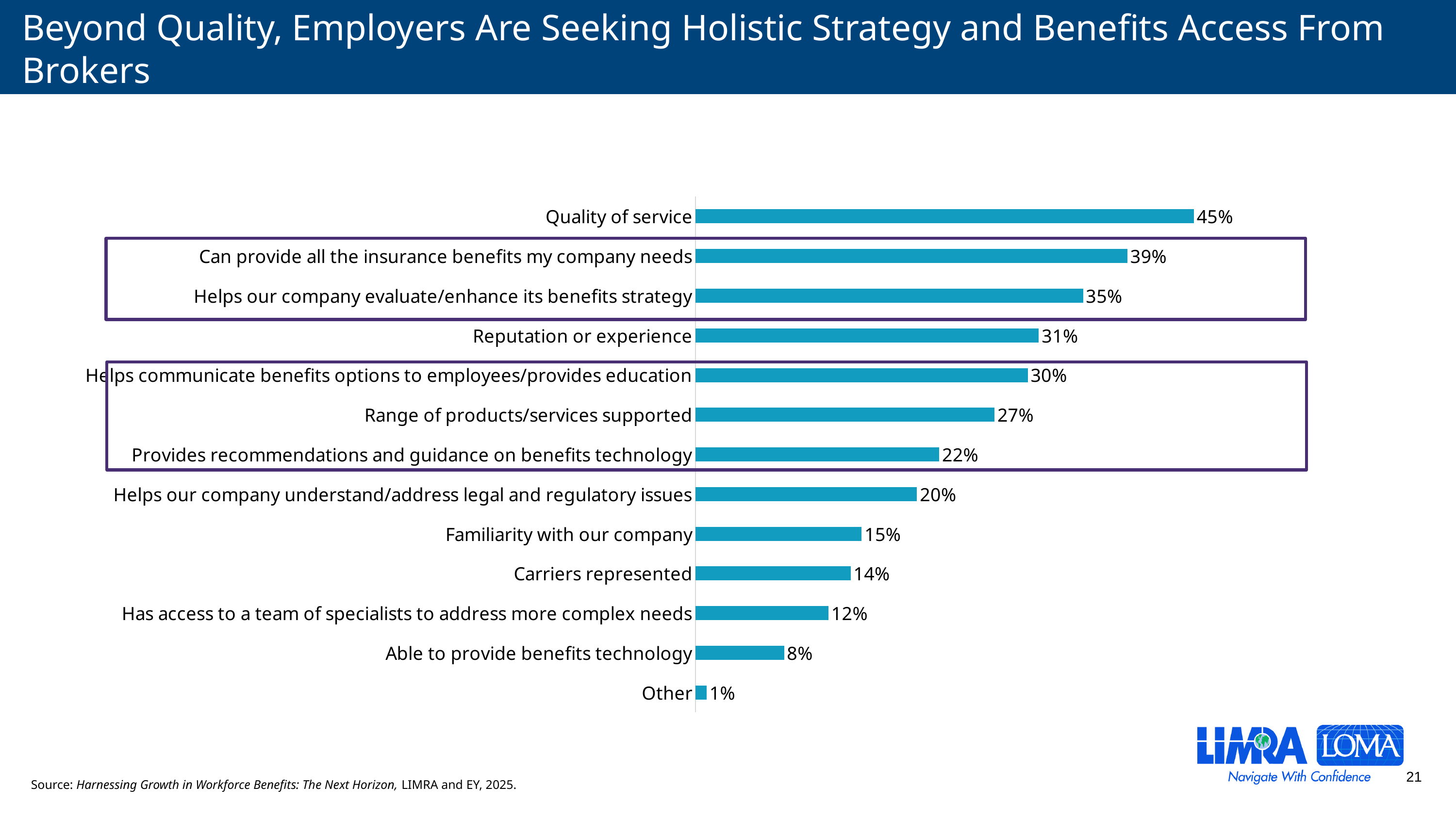
What is the value for Carriers represented? 14% How many categories are enclosed in the two outlined boxes in total? 5 What kind of chart is shown on the slide? Bar chart What is the value for Able to provide benefits technology? 8% What is the difference between Range of products/services supported and Provides recommendations and guidance on benefits technology? 5% Which is larger: Reputation or experience or Familiarity with our company? Reputation or experience What is the value for Helps our company evaluate/enhance its benefits strategy? 35% Which category has the highest value? Quality of service What is the value for Quality of service? 45% How many categories are shown in the chart? 13 What is the difference between Quality of service and Can provide all the insurance benefits my company needs? 6% Which category has the lowest value? Other